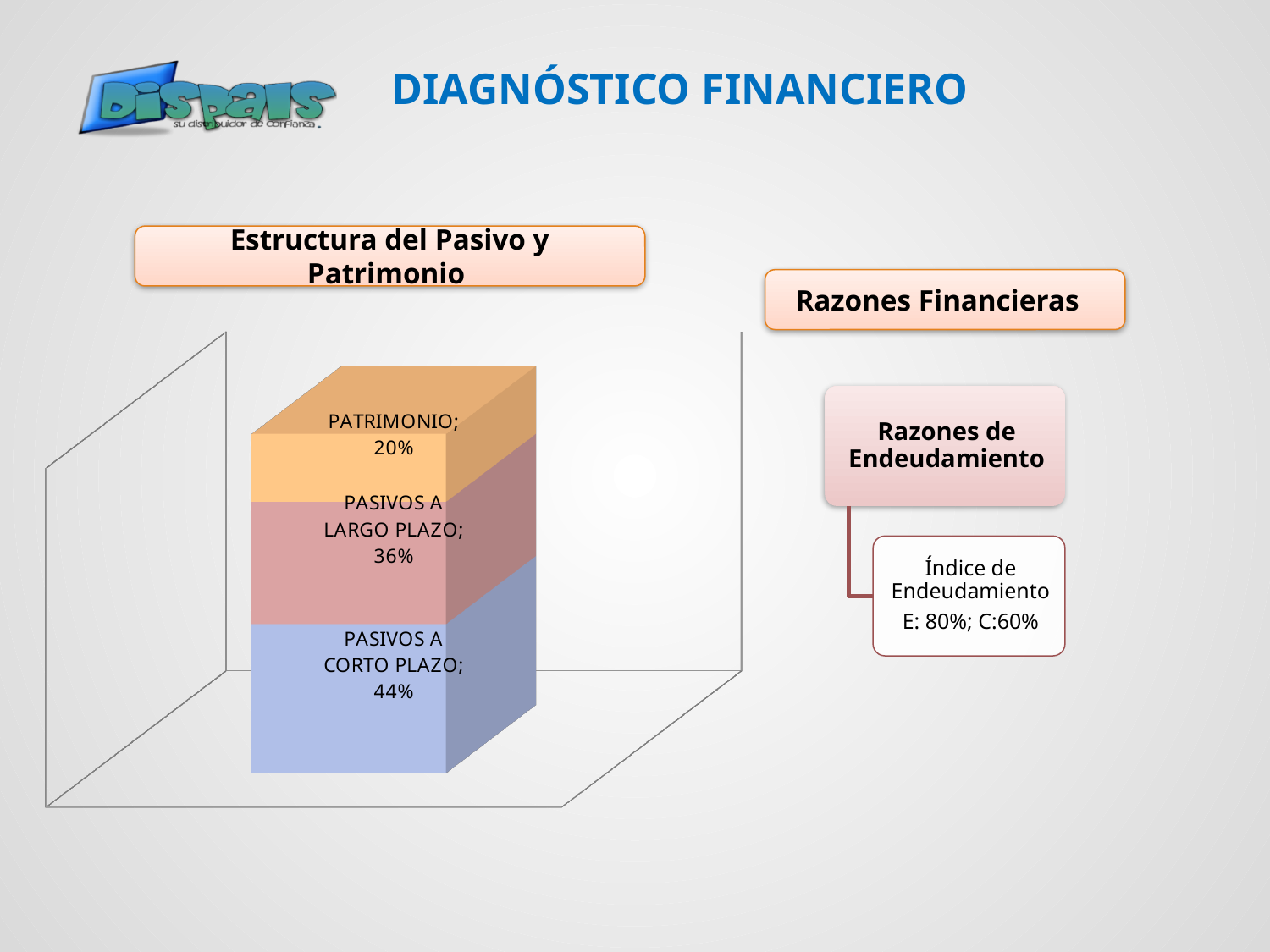
Which is larger, PASIVOS A LARGO PLAZO or PATRIMONIO? PASIVOS A LARGO PLAZO What is the difference between the PASIVOS A CORTO PLAZO and PASIVOS A LARGO PLAZO percentages? 8% Which segment of the stacked bar has the largest share? PASIVOS A CORTO PLAZO What percentage does the PATRIMONIO segment represent in the stacked bar? 20% What percentage does the PASIVOS A LARGO PLAZO segment represent? 36% What is the title shown above the chart? Estructura del Pasivo y Patrimonio How many segments make up the stacked bar? 3 What percentage does the PASIVOS A CORTO PLAZO segment represent? 44% Which segment of the stacked bar has the smallest share? PATRIMONIO What is the difference between the PASIVOS A LARGO PLAZO and PATRIMONIO percentages? 16% What kind of chart is shown on the slide? Stacked bar chart What is the total of the three segments in the stacked bar? 100%